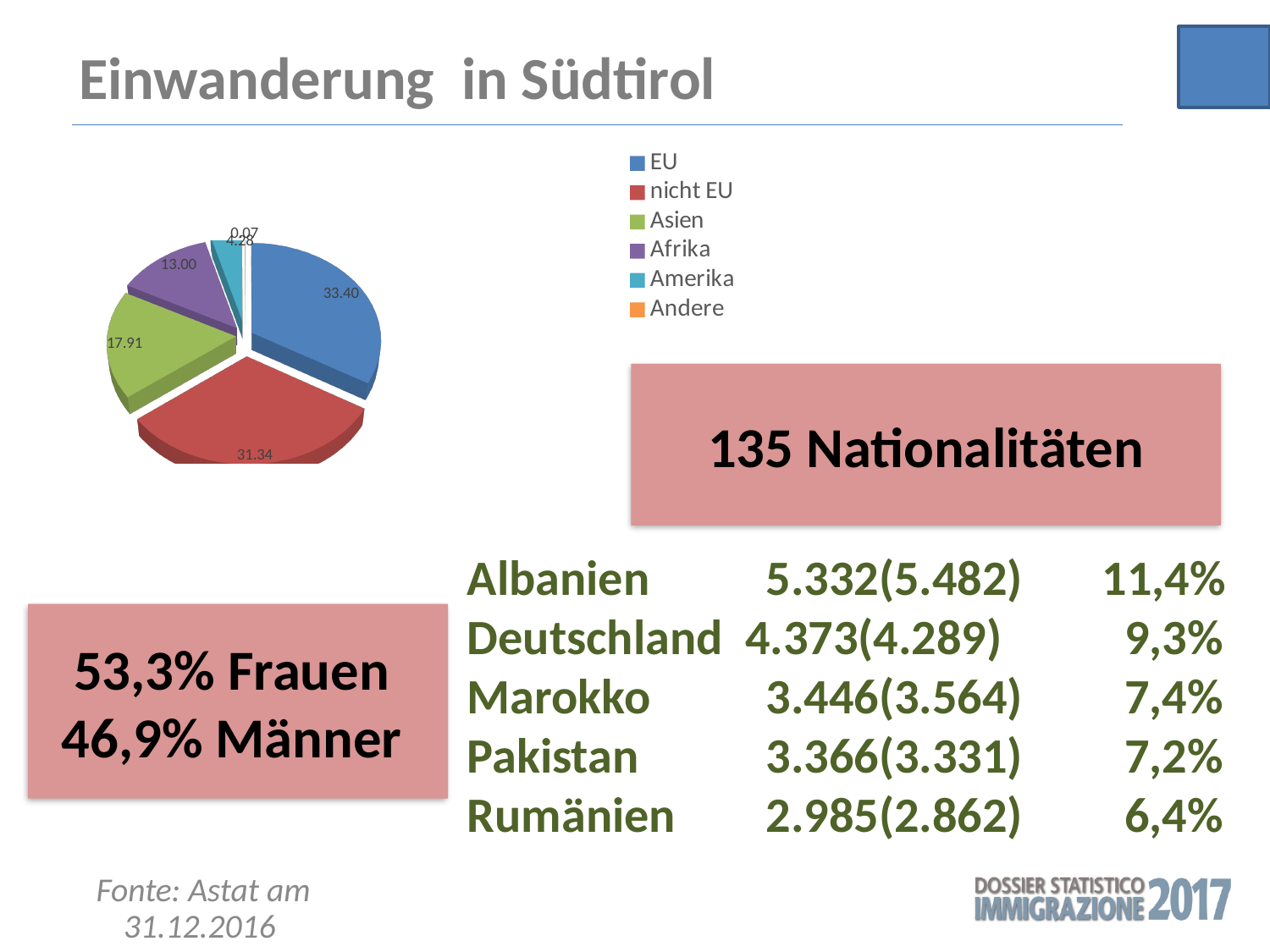
What is the value shown for the EU slice of the pie chart? 33.40 What is the value shown for the nicht EU slice of the pie chart? 31.34 What is the value shown for the Afrika slice of the pie chart? 13.00 What is the difference between the Asien value and the Afrika value in the pie chart? 4.91 Which category has the smallest slice in the pie chart? Andere What type of chart is shown on the slide? pie chart What is the value shown for the Asien slice of the pie chart? 17.91 Which colour represents Afrika in the pie chart? purple Which category has the largest slice in the pie chart? EU How many categories does the legend of the pie chart list? 6 What is the difference between the EU value and the nicht EU value in the pie chart? 2.06 Which is larger in the pie chart, Asien or Afrika? Asien